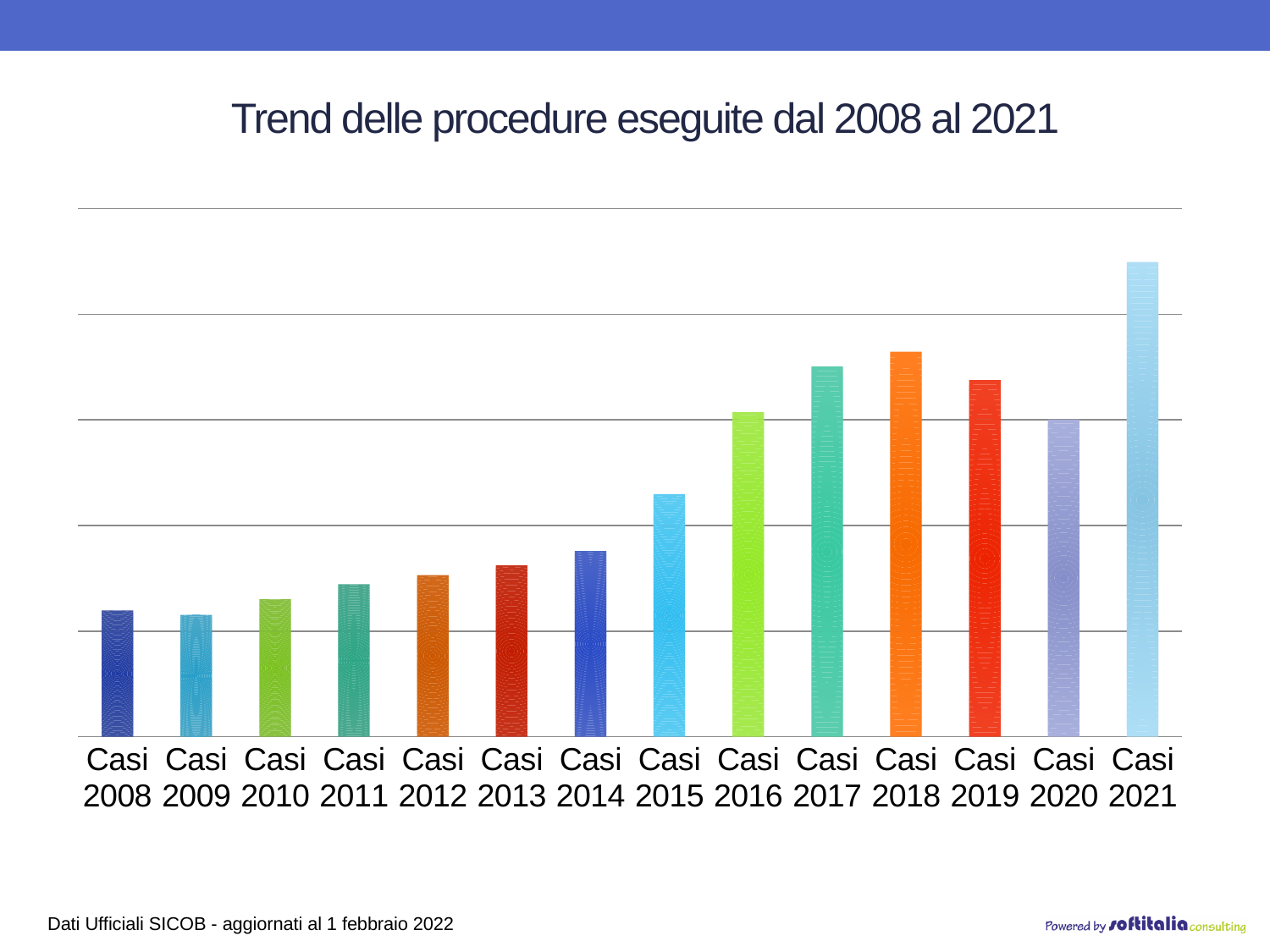
Which is larger, the value for Casi 2019 or Casi 2020? Casi 2019 Which is larger, the value for Casi 2012 or Casi 2014? Casi 2014 Which is larger, the value for Casi 2017 or Casi 2018? Casi 2018 Does the value fall or rise from Casi 2019 to Casi 2020? Fall How many categories (years) are plotted in the chart? 14 What type of chart is shown on the slide? Bar chart Which category has the highest bar? Casi 2021 What is the title of the chart? Trend delle procedure eseguite dal 2008 al 2021 Do the values generally rise or fall from 2008 to 2021? Rise According to the note at the bottom of the slide, what is the source of the data? Dati Ufficiali SICOB - aggiornati al 1 febbraio 2022